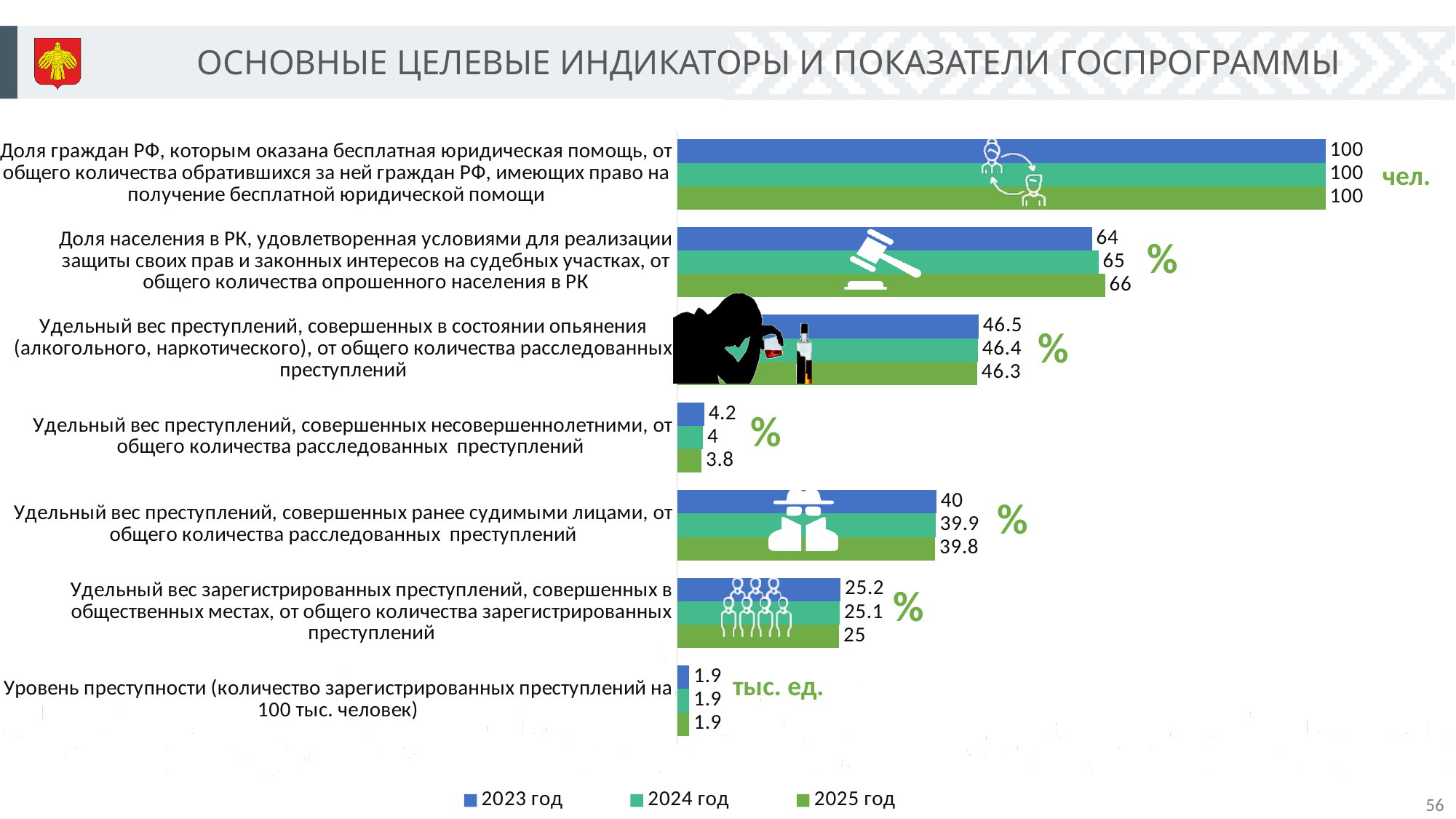
What is the difference between the 2023 год and 2025 год values for "Доля населения в РК, удовлетворенная условиями для реализации защиты своих прав"? 2 What is the 2024 год value for "Удельный вес преступлений, совершенных ранее судимыми лицами"? 39.9 How many series does the legend list? 3 What kind of chart is shown on the slide? bar chart Do the values for "Удельный вес преступлений, совершенных в состоянии опьянения" rise or fall from 2023 год to 2025 год? fall Which indicator has the highest values across all three years? Доля граждан РФ, которым оказана бесплатная юридическая помощь What is the 2025 год value for "Удельный вес зарегистрированных преступлений, совершенных в общественных местах"? 25 What is the 2025 год value for "Доля населения в РК, удовлетворенная условиями для реализации защиты своих прав и законных интересов на судебных участках"? 66 What is the 2023 год value for "Удельный вес преступлений, совершенных несовершеннолетними, от общего количества расследованных преступлений"? 4.2 Which is larger for 2023 год: the value for "Удельный вес преступлений, совершенных ранее судимыми лицами" or for "Удельный вес зарегистрированных преступлений, совершенных в общественных местах"? Удельный вес преступлений, совершенных ранее судимыми лицами How many categories (indicators) are plotted in the chart? 7 What unit is shown next to the bars for "Уровень преступности (количество зарегистрированных преступлений на 100 тыс. человек)"? тыс. ед.